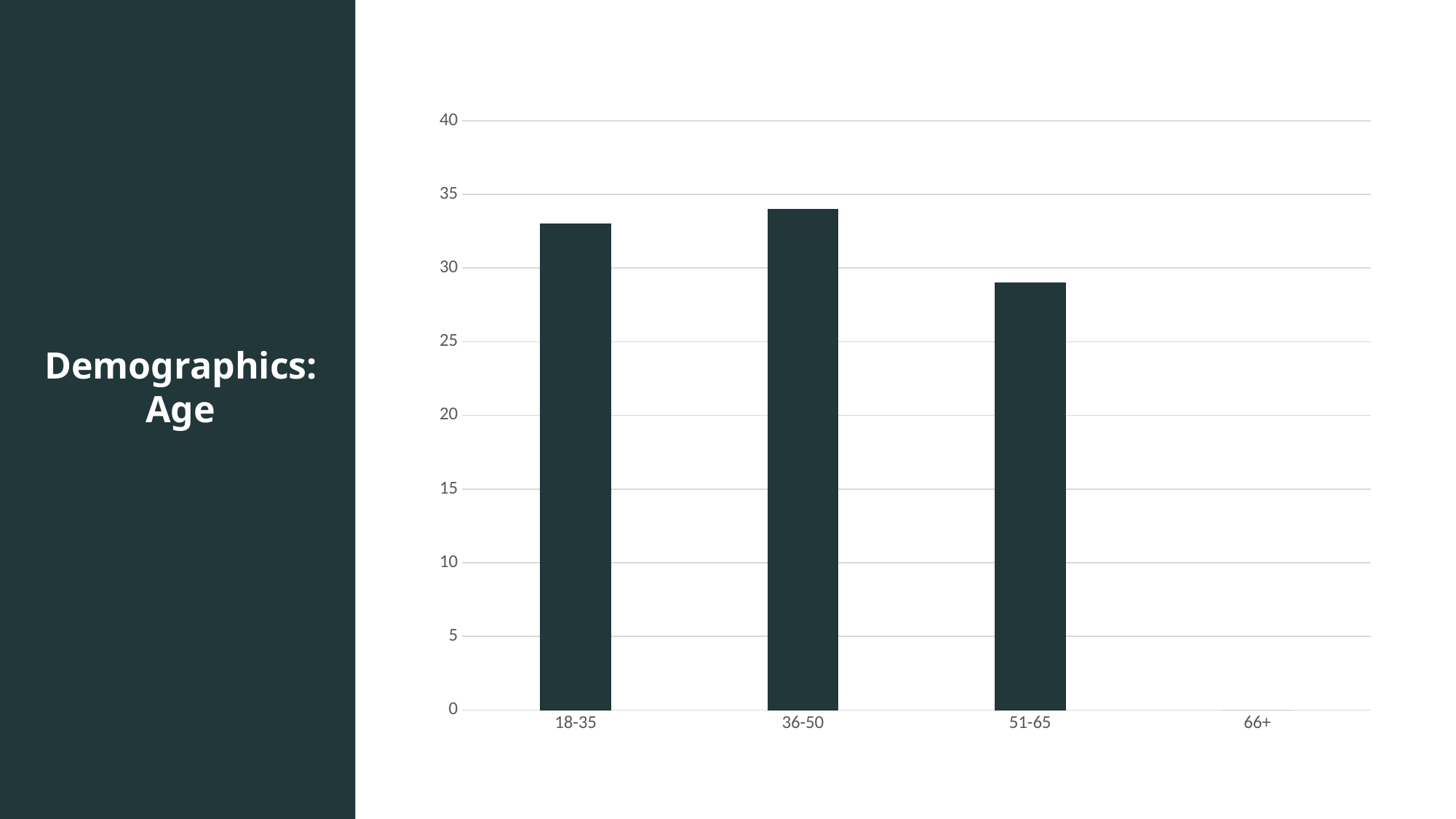
Is the value for the 51-65 age group greater or less than 25? greater Is the value for the 18-35 age group greater or less than 35? less Which has the larger value, the 18-35 age group or the 51-65 age group? 18-35 Is the value for the 18-35 age group greater or less than 30? greater How many age categories are shown on the x axis of the chart? 4 What is the highest value labelled on the vertical axis of the chart? 40 What kind of chart is shown on the slide? bar chart Which has the larger value, the 36-50 age group or the 51-65 age group? 36-50 What is the title shown on the slide for this chart? Demographics: Age